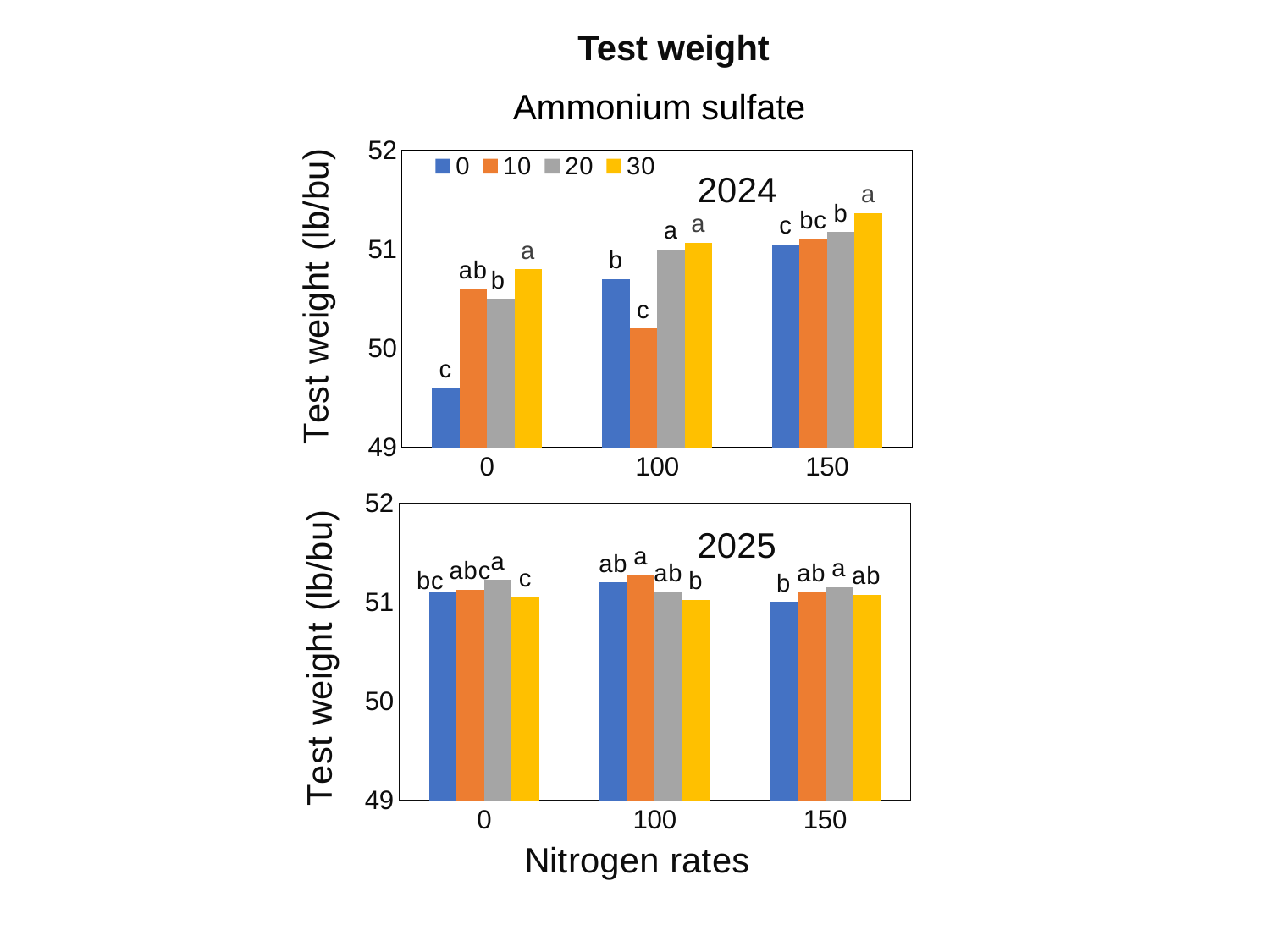
In the 2024 chart, which series has the lowest value at nitrogen rate 0? 0 In the 2024 chart, which series has the lowest value at nitrogen rate 100? 10 How many nitrogen rate categories are shown on the x axis of the 2025 chart? 3 In the 2025 chart, is the value for series 0 at nitrogen rate 0 greater or less than 50? greater In the 2024 chart, at nitrogen rate 100, which is larger: the value for series 0 or the value for series 10? series 0 How many series does the legend of the 2024 chart list? 4 In the 2024 chart, is the value for series 0 at nitrogen rate 0 greater or less than 50? less In the 2024 chart, which series has the highest value at nitrogen rate 150? 30 What kind of chart is the 2024 chart at the top of the slide? bar chart What is the label of the x axis shared by the two charts? Nitrogen rates In the 2024 chart, is the value for series 30 at nitrogen rate 150 greater or less than 51? greater In the 2024 chart, do the values for series 0 rise or fall as the nitrogen rate increases from 0 to 150? rise